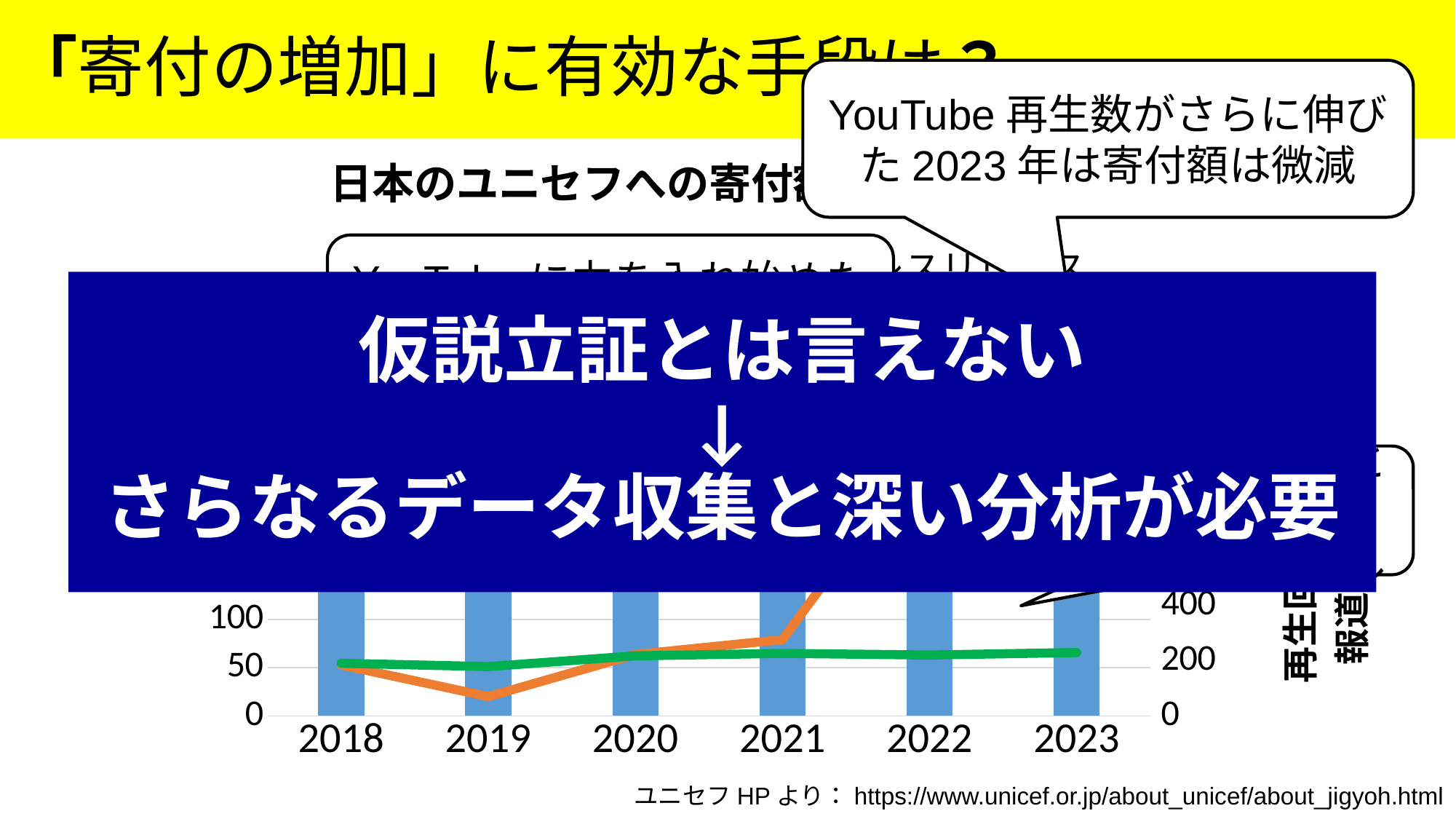
Does the orange line rise or fall from 2019 to 2021? Rise Does the orange line rise or fall from 2018 to 2019? Fall How many years are shown on the x axis of the chart? 6 What kind of chart is shown on the slide? A combination chart with bars and lines What is the last year shown on the x axis of the chart? 2023 What is the highest tick label visible on the right axis of the chart? 400 Is the orange line's 2019 point above or below the 50 gridline of the left axis? Below In 2019, which line is higher, the orange line or the green line? The green line In 2021, which line is higher, the orange line or the green line? The orange line In which year does the orange line reach its lowest point? 2019 What is the first year shown on the x axis of the chart? 2018 What colour are the bars in the chart? Blue